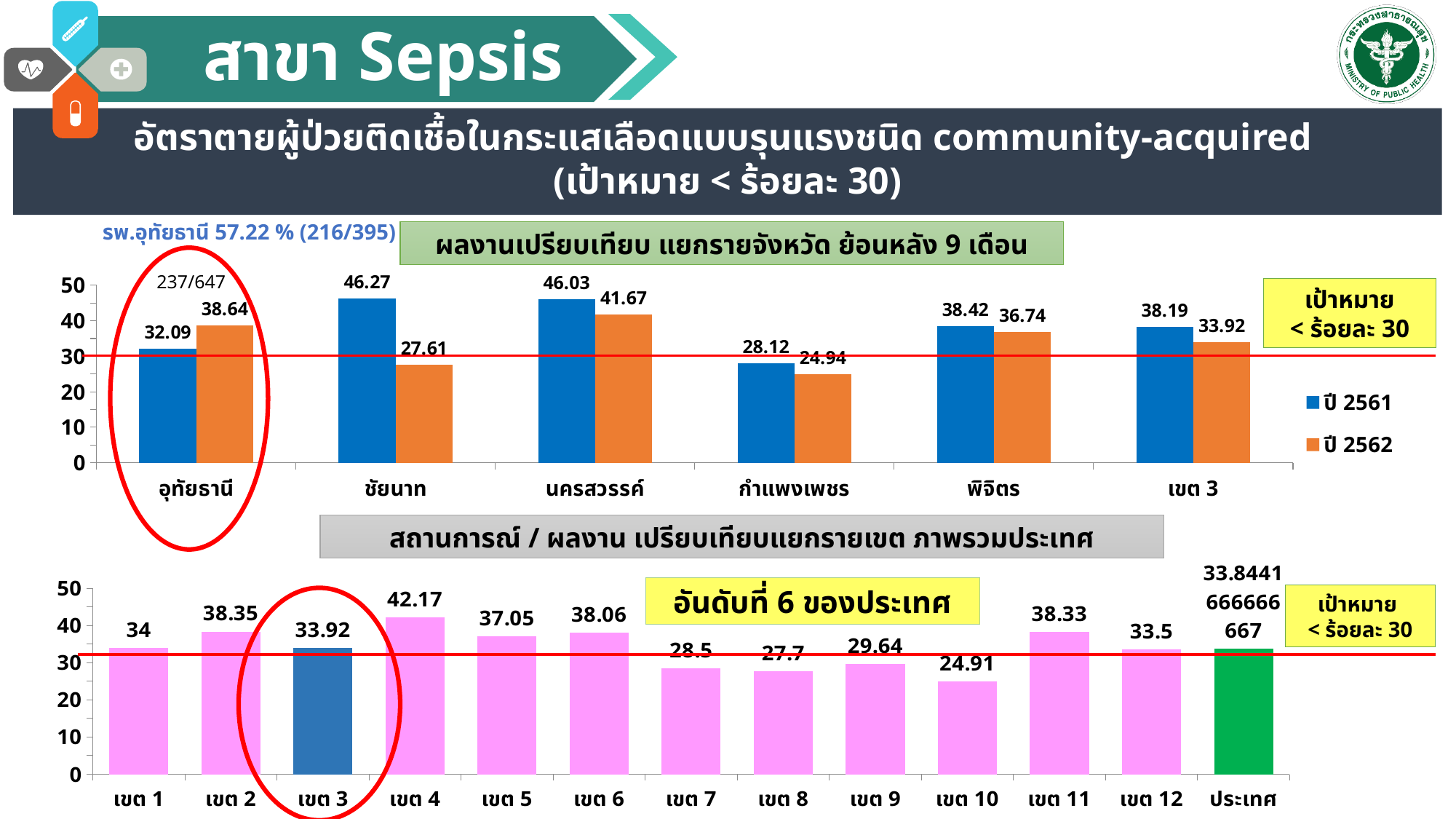
In the bottom chart, which category has the highest value? เขต 4 What type of chart is the bottom chart? bar chart In the top chart, how many series does the legend list? 2 In the top chart, what is the value for ชัยนาท in ปี 2562? 27.61 In the top chart, what is the difference between the ปี 2561 and ปี 2562 values for ชัยนาท? 18.66 In the bottom chart, what is the value for เขต 4? 42.17 In the bottom chart, which category has the lowest value? เขต 10 In the top chart, which province has the highest value for ปี 2561? ชัยนาท In the top chart, is the ปี 2562 value for อุทัยธานี larger or smaller than its ปี 2561 value? larger In the top chart, what is the value for นครสวรรค์ in ปี 2561? 46.03 In the top chart, which category has the lowest value for ปี 2562? กำแพงเพชร In the bottom chart, how many categories are shown on the x axis? 13